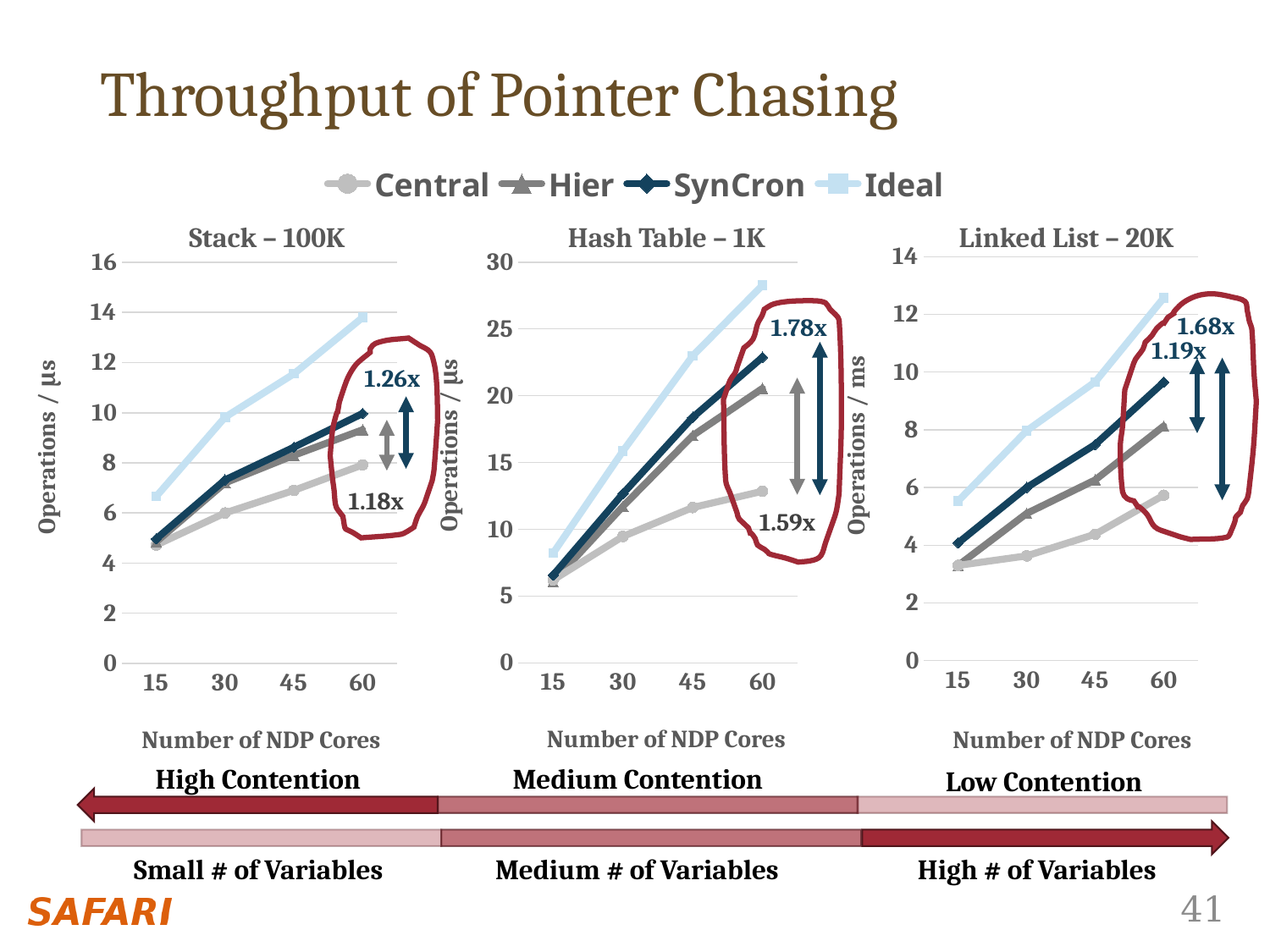
In the 'Hash Table – 1K' chart, which series has the lowest value at 60 NDP cores? Central In the 'Hash Table – 1K' chart, how many points are plotted along the x axis for each series? 4 In the 'Linked List – 20K' chart, is the value for SynCron at 60 NDP cores larger than the value for Hier at 60 NDP cores? Yes In the 'Hash Table – 1K' chart, is the value for Central at 60 NDP cores greater or less than 15? less What kind of chart is used in the 'Stack – 100K' panel? Line chart What is the y-axis label of the 'Linked List – 20K' chart? Operations / ms What speedup annotation is written at the top of the circled region in the 'Hash Table – 1K' chart? 1.78x In the 'Hash Table – 1K' chart, do the SynCron values rise or fall as the number of NDP cores increases from 15 to 60? Rise In the 'Stack – 100K' chart, which series has the highest value at 60 NDP cores? Ideal How many series does the shared legend list? 4 In the 'Linked List – 20K' chart, is the value for Ideal at 60 NDP cores greater or less than 10? greater In the 'Stack – 100K' chart, is the value for Ideal at 60 NDP cores greater or less than 12? greater